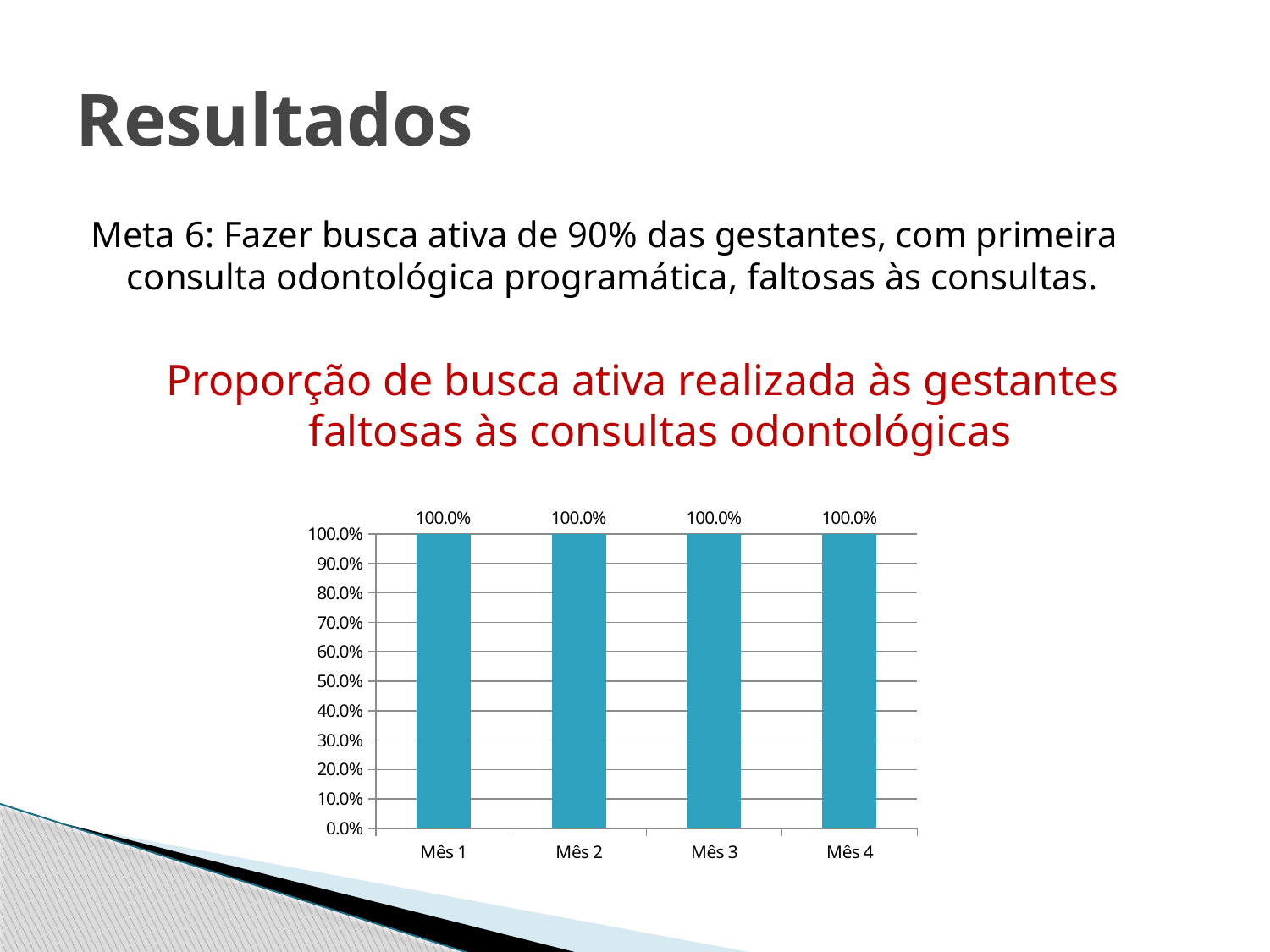
Do the values rise, fall, or stay the same from Mês 1 to Mês 4? Stay the same Is the value for Mês 3 greater or less than 50.0%? greater What is the label of the first category on the x axis? Mês 1 What is the value for Mês 3? 100.0% What is the value for Mês 1? 100.0% What is the title of the chart? Proporção de busca ativa realizada às gestantes faltosas às consultas odontológicas What is the difference between the values for Mês 1 and Mês 4? 0.0% How many categories (months) are shown on the x axis of the chart? 4 What kind of chart is shown on the slide? Bar chart What is the value for Mês 4? 100.0% What is the value for Mês 2? 100.0% Is the value for Mês 2 greater or less than 90.0%? greater